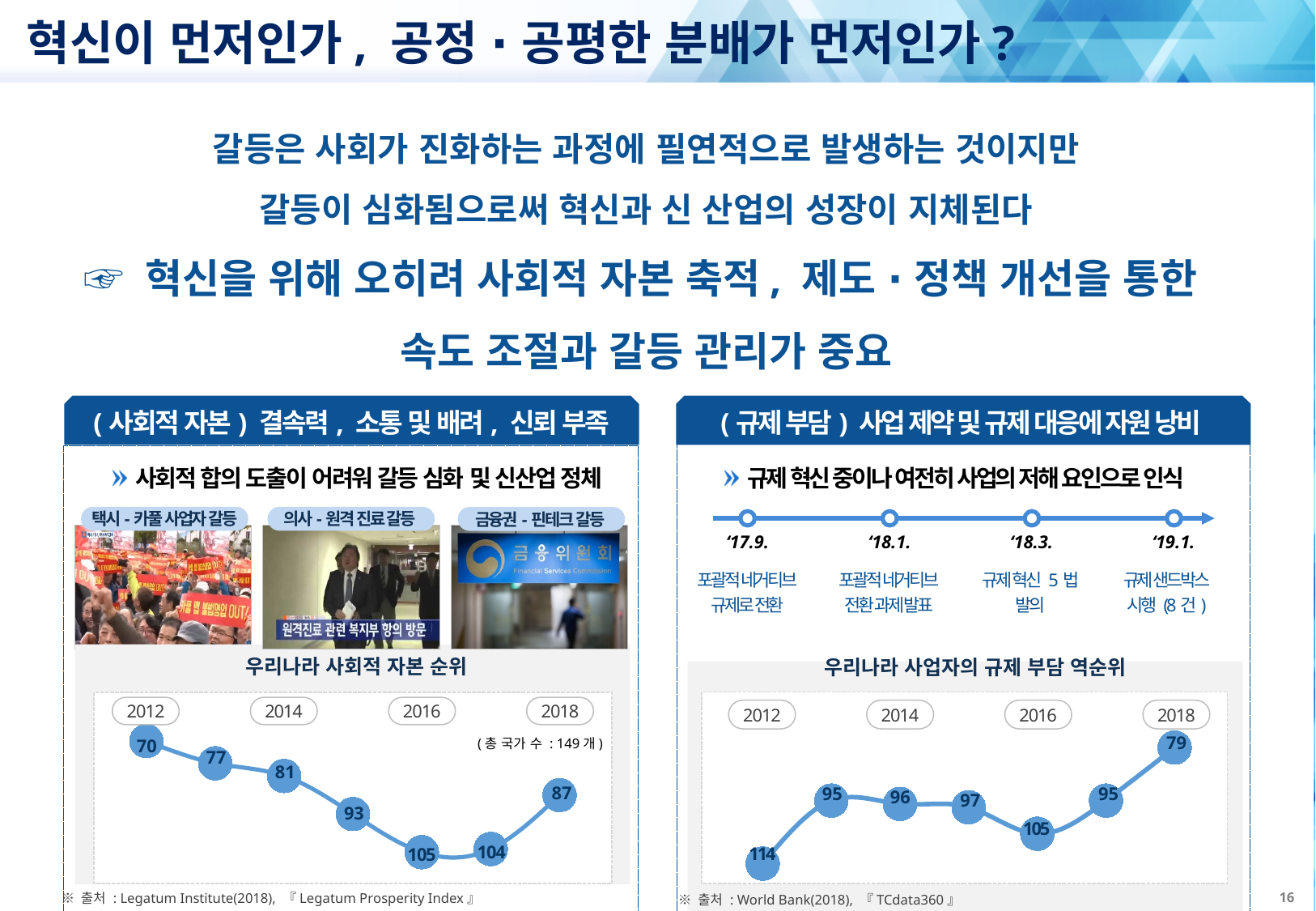
In the chart titled 우리나라 사업자의 규제 부담 역순위, what is the lowest value plotted? 79 In the chart titled 우리나라 사회적 자본 순위, what is the value for 2012? 70 In the chart titled 우리나라 사업자의 규제 부담 역순위, what is the value for 2012? 114 In the chart titled 우리나라 사회적 자본 순위, what is the highest value plotted? 105 In the chart titled 우리나라 사업자의 규제 부담 역순위, what is the value for 2018? 79 In the chart titled 우리나라 사회적 자본 순위, how many data points are plotted? 7 In the chart titled 우리나라 사회적 자본 순위, what is the value for 2018? 87 In the chart titled 우리나라 사회적 자본 순위, what total number of countries is noted in parentheses? 149개 In the chart titled 우리나라 사업자의 규제 부담 역순위, which is larger, the value for 2014 or the value for 2016? 2016 In the chart titled 우리나라 사업자의 규제 부담 역순위, what is the difference between the 2012 value and the 2018 value? 35 In the chart titled 우리나라 사회적 자본 순위, what is the difference between the 2016 value and the 2012 value? 35 What type of chart is 우리나라 사업자의 규제 부담 역순위? Line chart